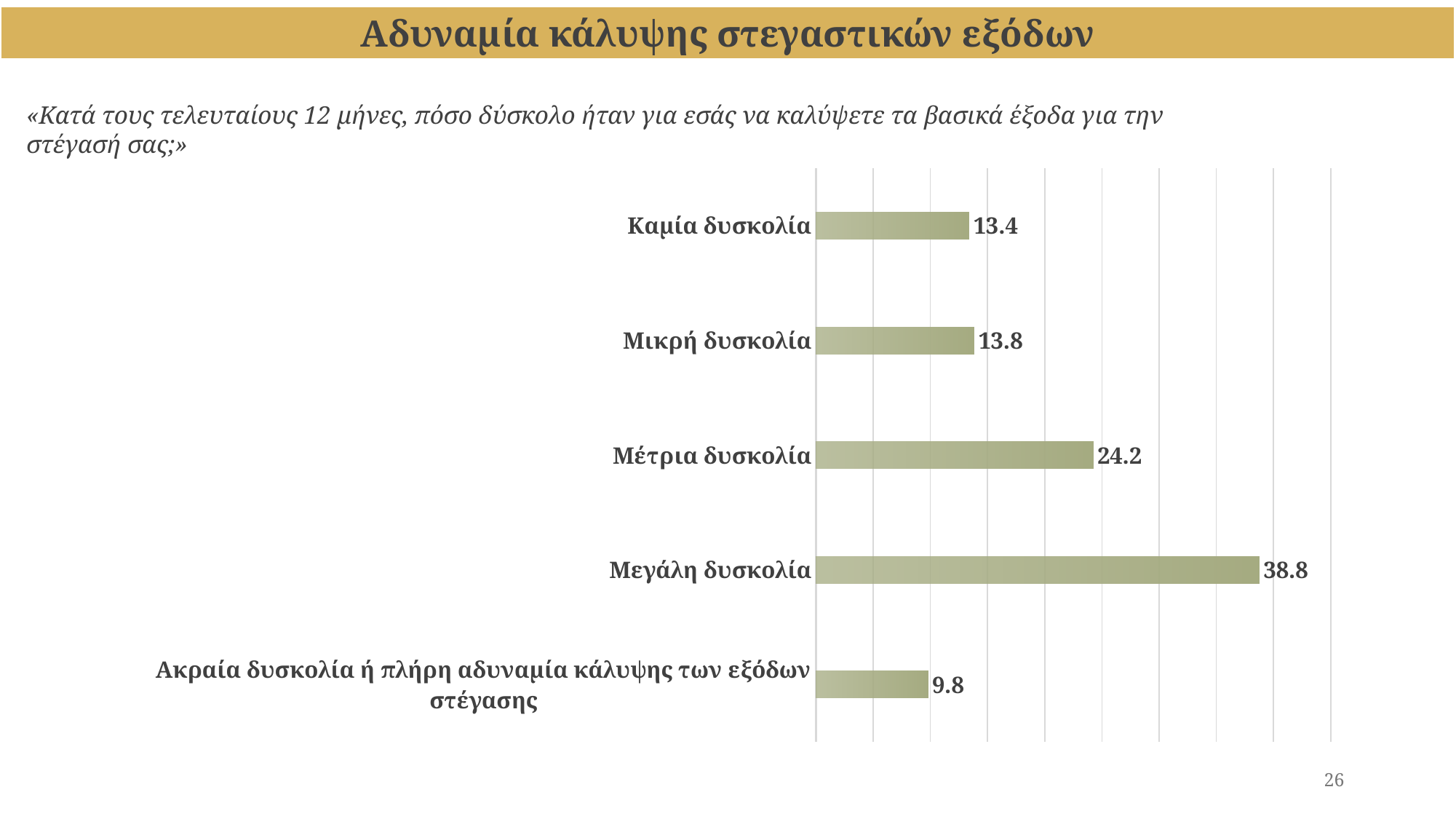
What is the difference between the values for Μέτρια δυσκολία and Καμία δυσκολία? 10.8 Which is larger, the value for Μέτρια δυσκολία or the value for Μικρή δυσκολία? Μέτρια δυσκολία What is the value for Καμία δυσκολία? 13.4 What is the value for Μέτρια δυσκολία? 24.2 Which category has the lowest value? Ακραία δυσκολία ή πλήρη αδυναμία κάλυψης των εξόδων στέγασης What is the value for Μεγάλη δυσκολία? 38.8 How many categories are shown in the chart? 5 Which category has the highest value? Μεγάλη δυσκολία What is the value for Μικρή δυσκολία? 13.8 What is the difference between the values for Μεγάλη δυσκολία and Μέτρια δυσκολία? 14.6 What is the value for Ακραία δυσκολία ή πλήρη αδυναμία κάλυψης των εξόδων στέγασης? 9.8 What kind of chart is shown on the slide? Bar chart